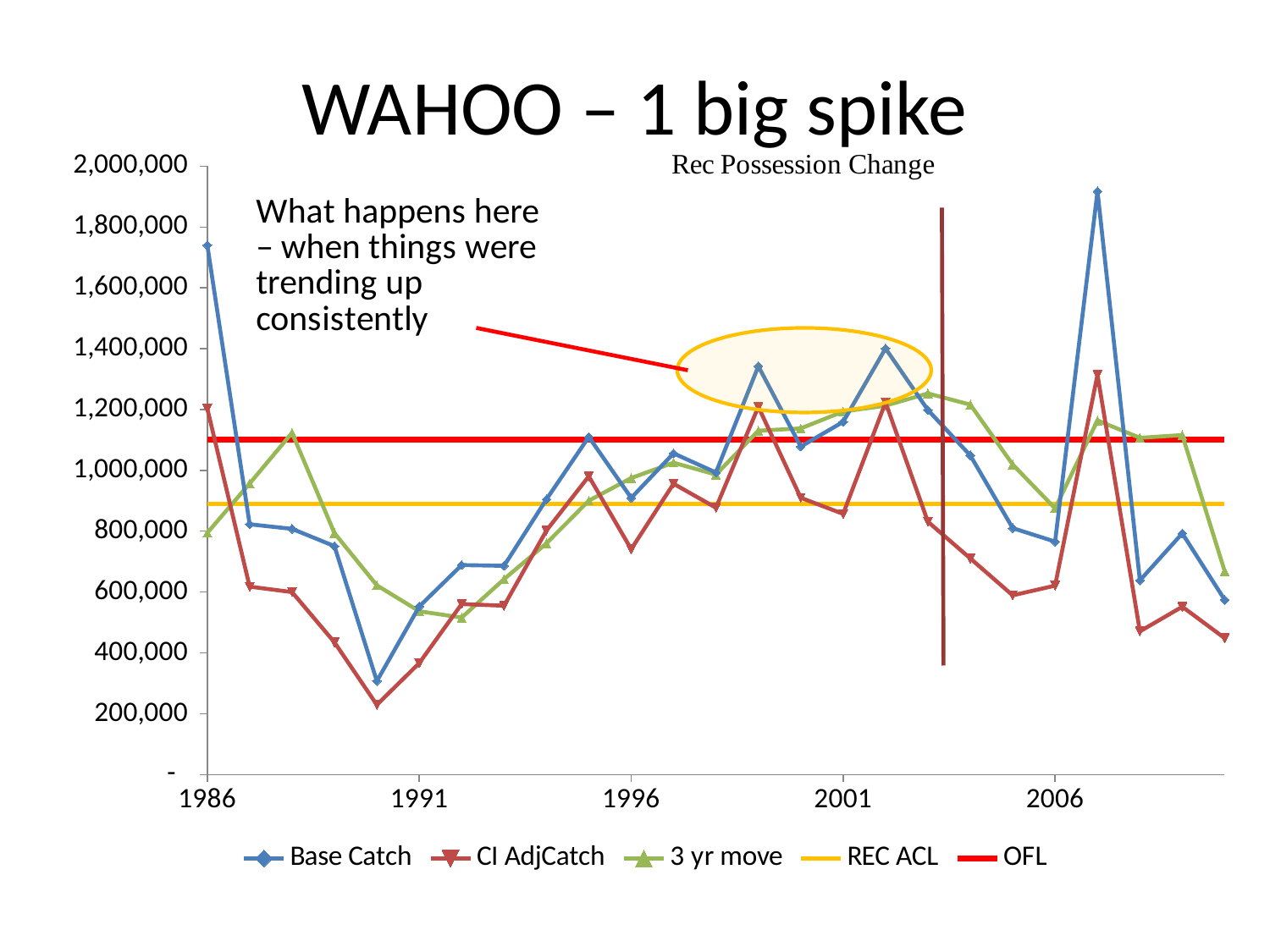
Is the CI AdjCatch value for 1990 greater or less than 400,000? less In which year does the Base Catch series reach its highest value? 2007 Is the REC ACL line greater or less than 1,000,000? less Is the Base Catch value for 1986 greater or less than 1,600,000? greater In 1986, which is larger: Base Catch or CI AdjCatch? Base Catch Which series is drawn as the thick red horizontal line? OFL Does the Base Catch series rise or fall from 1990 to 1995? rise How many series does the legend list? 5 What is the title of the chart? Rec Possession Change In which year does the Base Catch series reach its lowest value? 1990 What kind of chart is shown on the slide? line chart